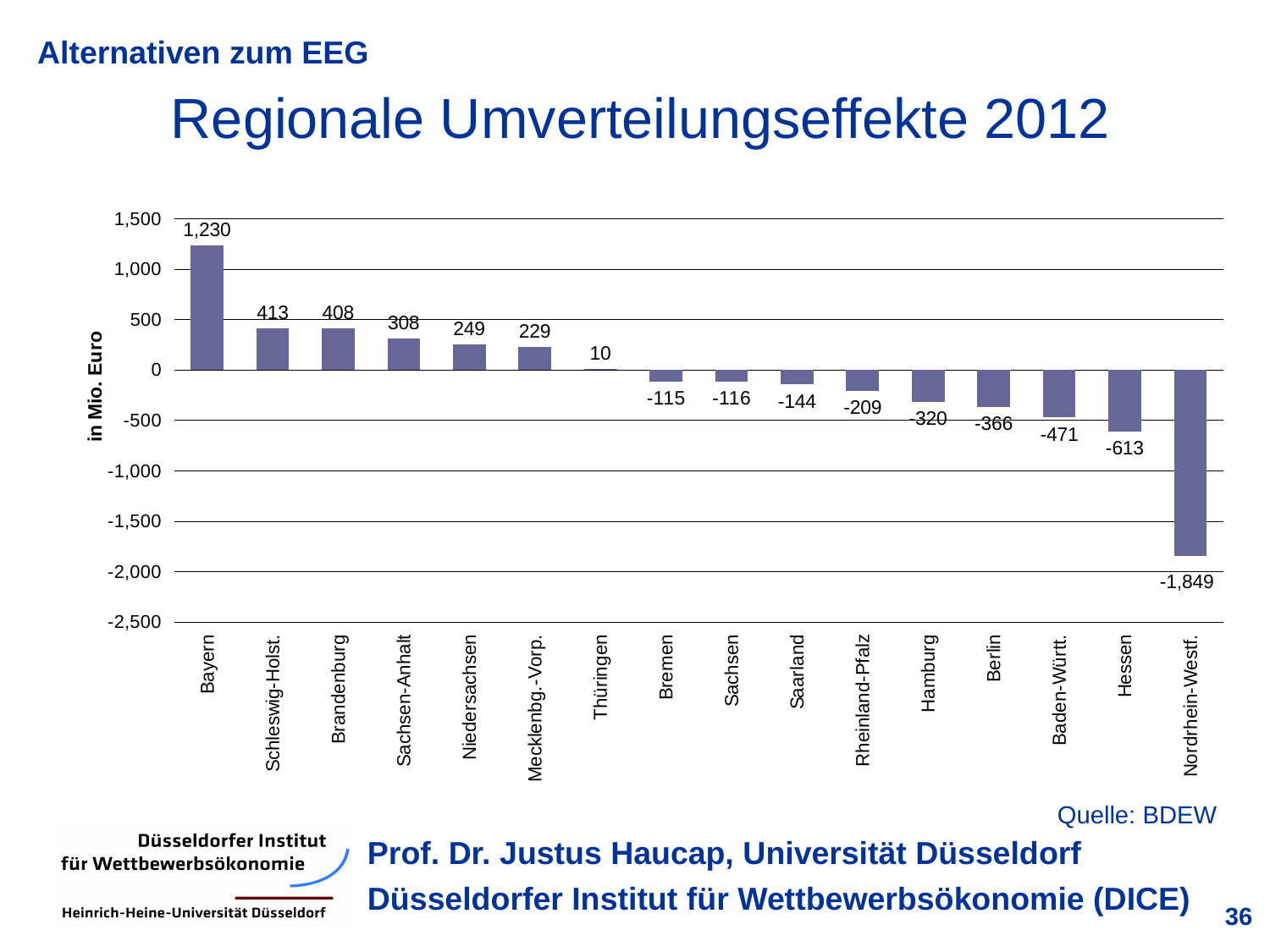
Which category has the highest value? Bayern What is the value for Bayern? 1,230 What is the value for Hessen? -613 Do the values rise or fall from left to right along the x axis? Fall What is the value for Thüringen? 10 How many categories are shown on the x axis? 16 What is the value for Nordrhein-Westf.? -1,849 What is the difference between the values for Schleswig-Holst. and Brandenburg? 5 Which has a larger value, Hamburg or Berlin? Hamburg What is the label of the y axis? in Mio. Euro Which category has the lowest value? Nordrhein-Westf. What kind of chart is shown on the slide? Bar chart